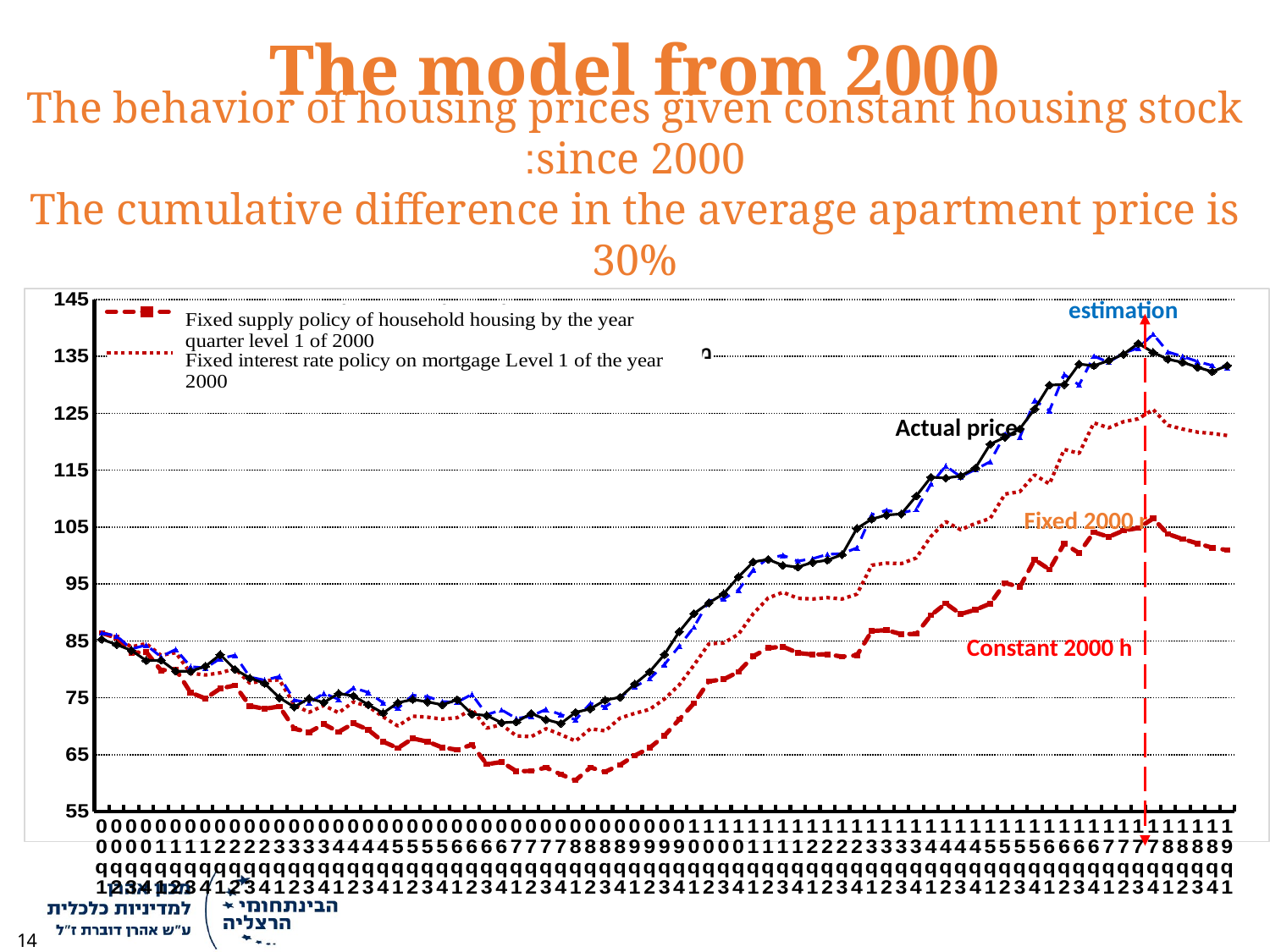
Does the Actual price line rise or fall between 2008 and 2017? rise Is the value of the Constant 2000 h line at the right end of the chart greater or less than 105? less Is the value of the Actual price line at the right end of the chart (2019) greater or less than 125? greater What is the main title of the slide? The model from 2000 Does the Actual price line rise or fall between 2000 and 2007? fall Is the peak of the Actual price line greater or less than 125? greater What kind of chart is shown on the slide? line chart According to the subtitle, what is the cumulative difference in the average apartment price? 30% At the right end of the chart, which is higher: the Actual price line or the Constant 2000 h line? Actual price Which labelled line is the lowest at the right end of the chart? Constant 2000 h